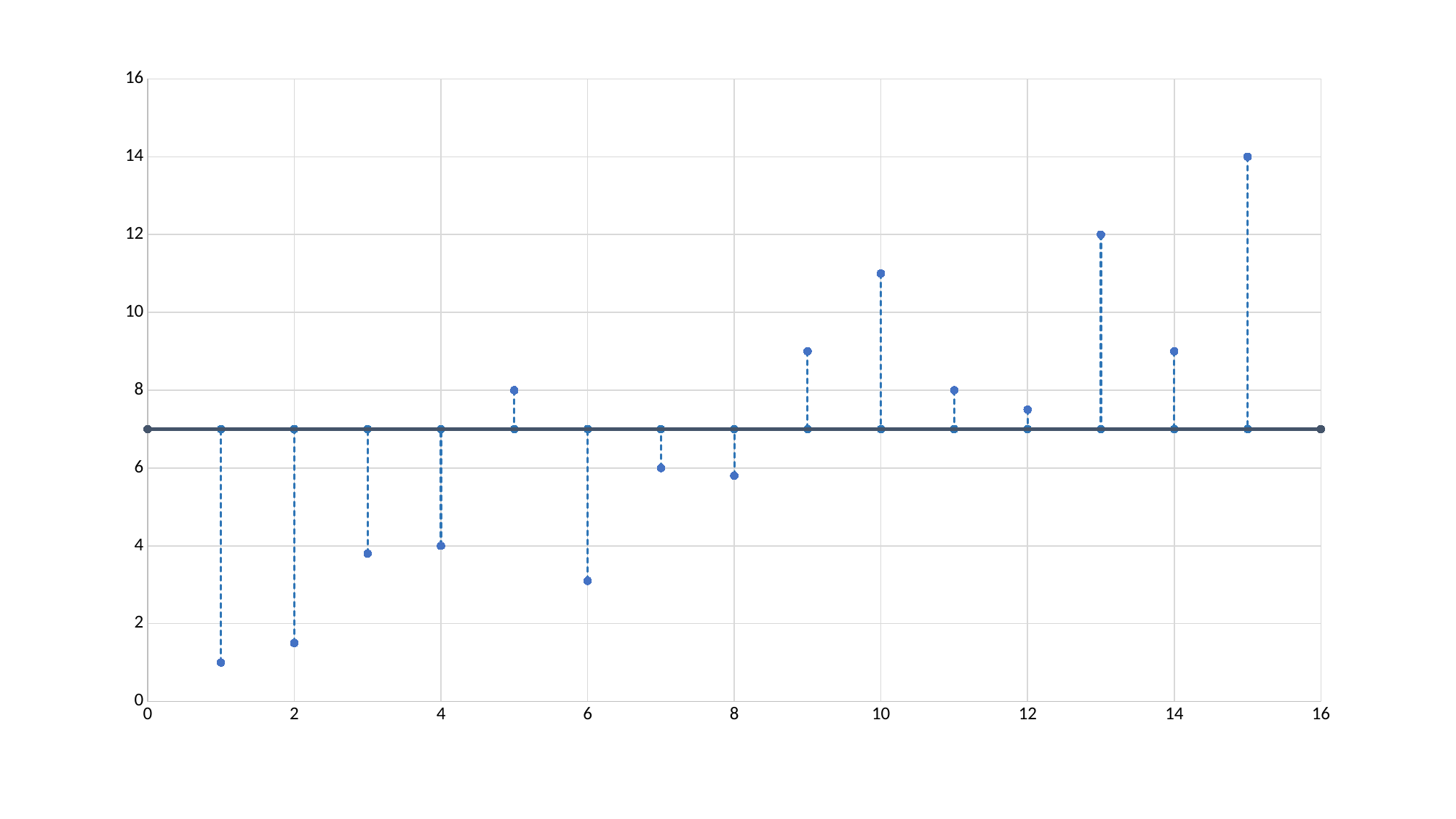
At which x value is the plotted point lowest? 1 Is the y value of the point at x = 6 greater or less than 4? less What is the y value of the point at x = 5? 8 What kind of chart is shown on the slide? scatter chart What is the y value of the point at x = 13? 12 What is the y value of the point at x = 4? 4 How many plotted points (excluding the horizontal reference line) are shown on the chart? 15 What is the difference between the y values of the points at x = 15 and x = 13? 2 At which x value is the plotted point highest? 15 What is the y value of the point at x = 15? 14 Is the y value of the point at x = 10 greater or less than 10? greater Which point has the larger y value, the one at x = 10 or the one at x = 13? x = 13